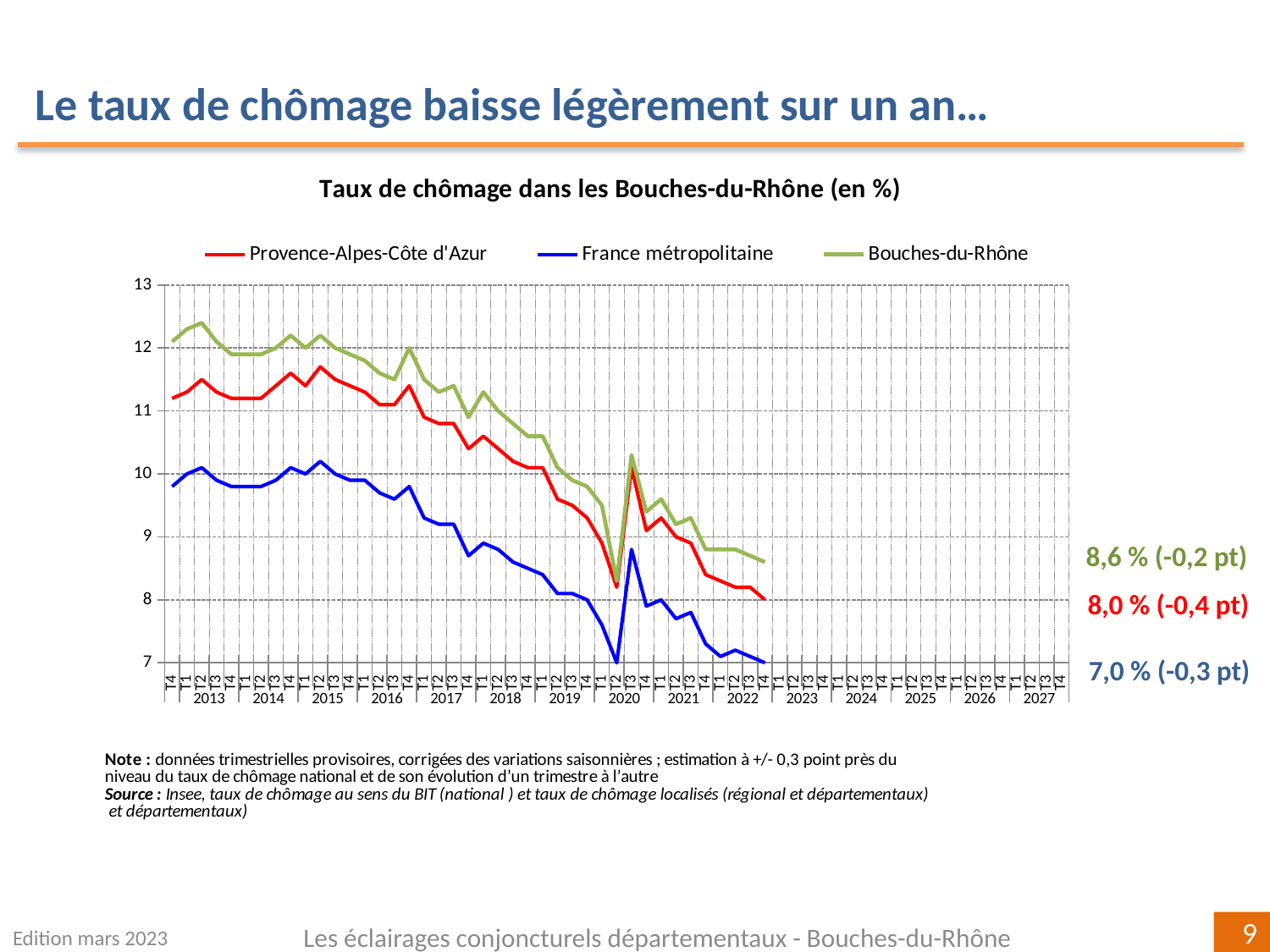
Overall, do the unemployment rates rise or fall from 2013 to 2022? fall How many series does the legend list? 3 What is the difference between the latest rates for Bouches-du-Rhône and France métropolitaine? 1,6 points By how many points did the Provence-Alpes-Côte d'Azur rate change over one year, according to the label? -0,4 pt Which series has the lowest latest value? France métropolitaine Is the value for Bouches-du-Rhône in T2 2013 greater or less than 12? greater Which series has the highest latest value? Bouches-du-Rhône What kind of chart is shown on the slide? line chart What is the latest unemployment rate shown for Bouches-du-Rhône? 8,6 % What is the latest unemployment rate shown for France métropolitaine? 7,0 % What is the latest unemployment rate shown for Provence-Alpes-Côte d'Azur? 8,0 % What colour is the Bouches-du-Rhône line? green